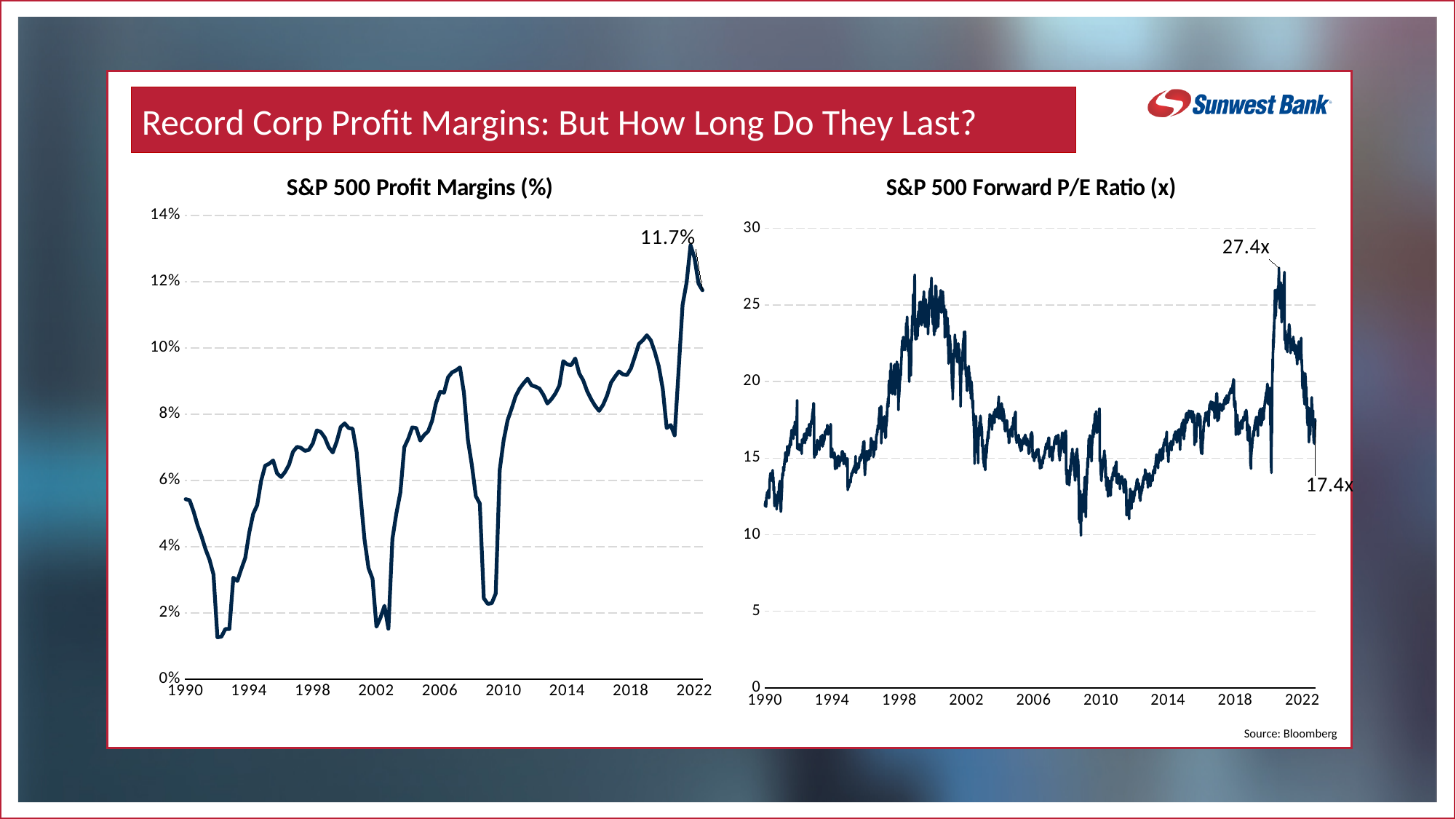
What kind of chart is the S&P 500 Profit Margins (%) chart? line chart On the S&P 500 Forward P/E Ratio (x) chart, what is the labelled value at the end of the series? 17.4x On the S&P 500 Profit Margins (%) chart, is the value at the 2009 trough greater or less than 4%? less On the S&P 500 Forward P/E Ratio (x) chart, is the value in 1990 greater or less than 15? less What kind of chart is the S&P 500 Forward P/E Ratio (x) chart? line chart On the S&P 500 Forward P/E Ratio (x) chart, what is the labelled peak value near 2021? 27.4x On the S&P 500 Forward P/E Ratio (x) chart, which labelled value is larger, 27.4x or 17.4x? 27.4x On the S&P 500 Profit Margins (%) chart, what is the labelled value at the end of the series? 11.7% On the S&P 500 Forward P/E Ratio (x) chart, what is the difference between the labelled peak of 27.4x and the labelled end value of 17.4x? 10.0x On the S&P 500 Profit Margins (%) chart, do values overall rise or fall from 1990 to 2022? rise On the S&P 500 Forward P/E Ratio (x) chart, is the value at the peak around 2000 greater or less than 25? greater What is the source cited for the charts on the slide? Bloomberg